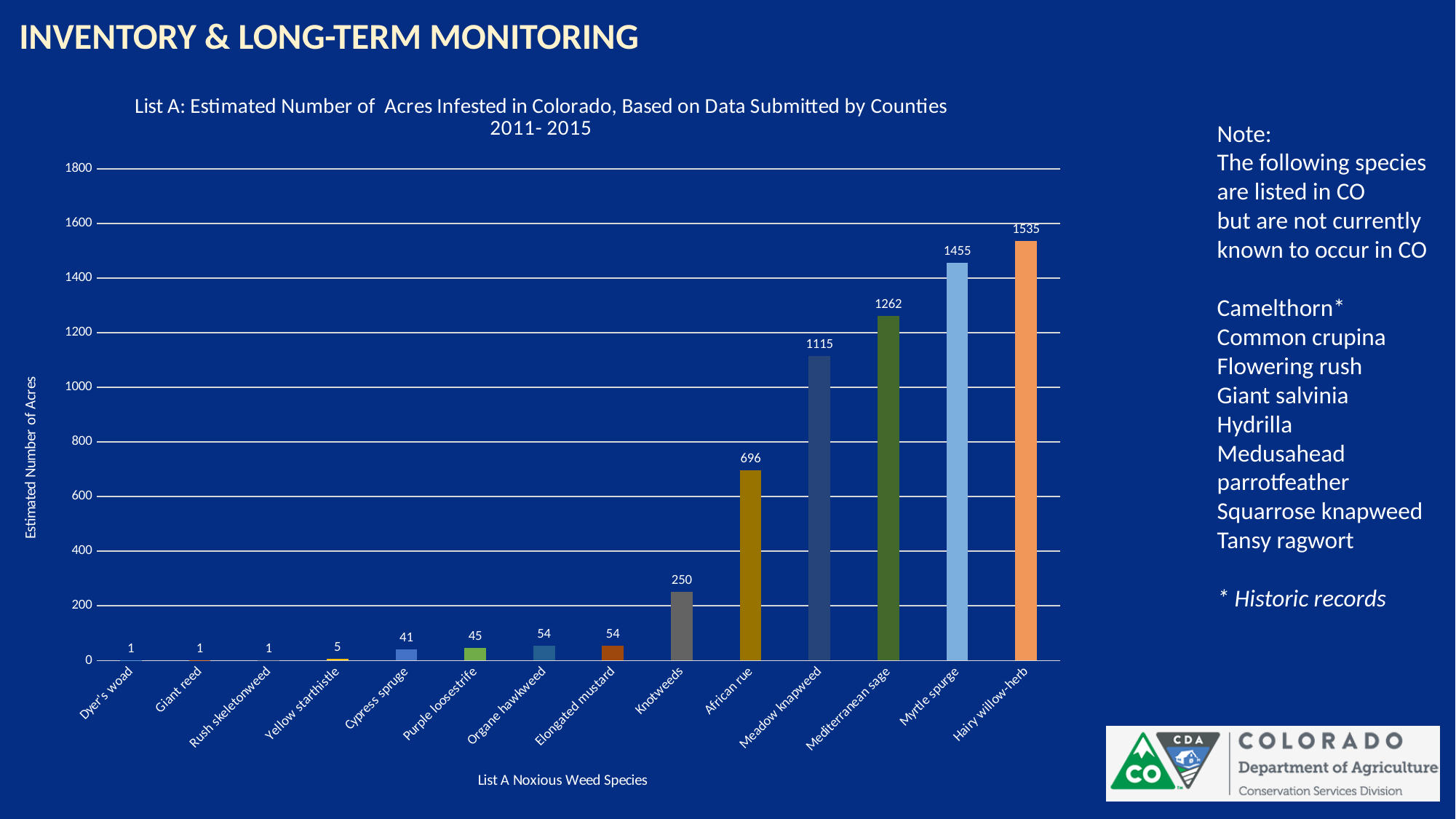
What is the estimated number of acres infested for Knotweeds? 250 How many weed species are shown on the x axis of the chart? 14 What is the estimated number of acres infested for African rue? 696 Which species has the highest estimated number of acres infested? Hairy willow-herb Which has more estimated acres infested, Meadow knapweed or African rue? Meadow knapweed Is the value for Myrtle spurge greater or less than 1400? greater What kind of chart is shown on the slide? Bar chart What is the difference in estimated acres between Mediterranean sage and Meadow knapweed? 147 What is the label of the y axis of the chart? Estimated Number of Acres What is the estimated number of acres infested for Cypress spurge? 41 What is the estimated number of acres infested for Hairy willow-herb? 1535 What is the difference in estimated acres between Hairy willow-herb and Myrtle spurge? 80